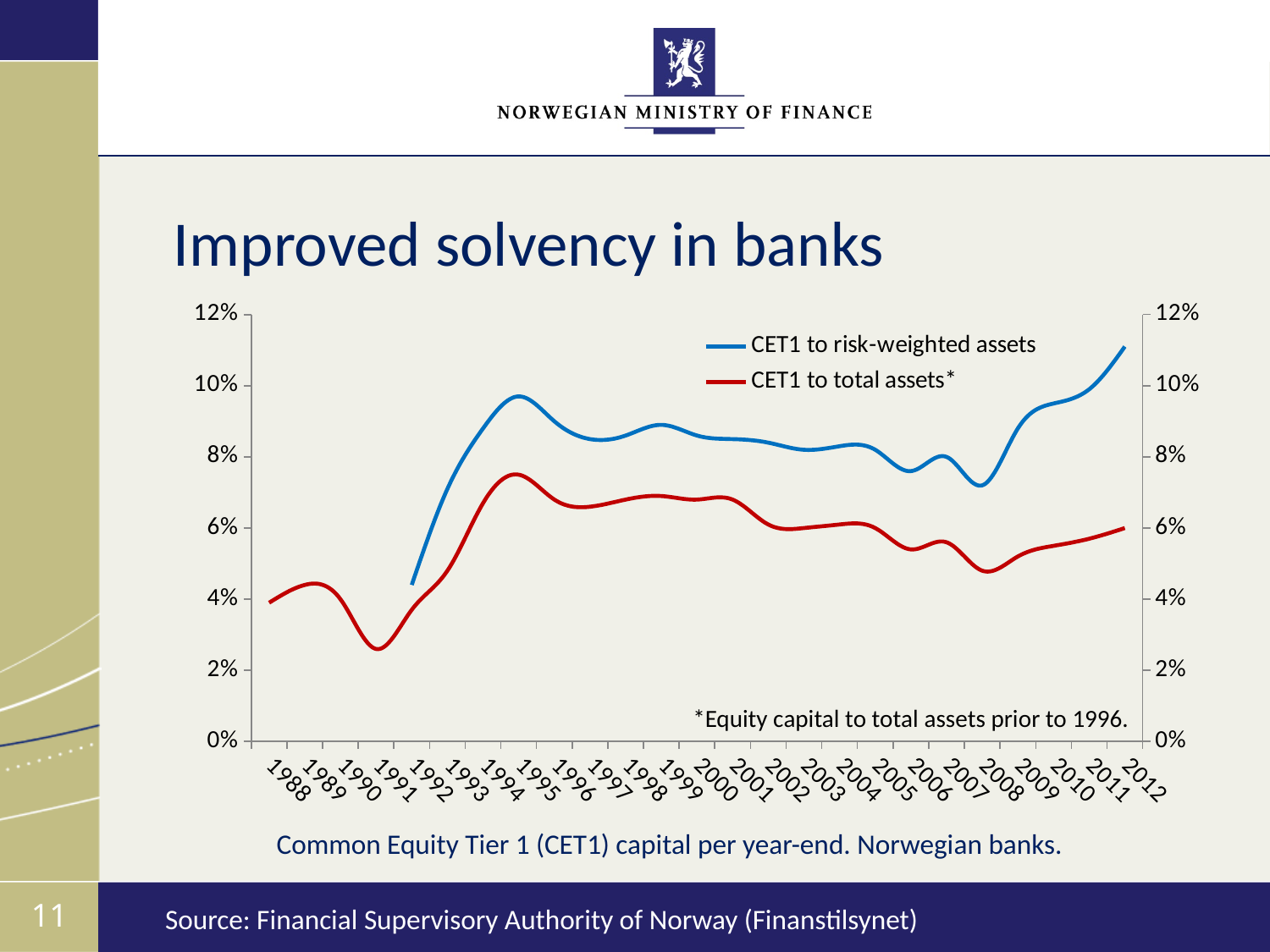
Does CET1 to risk-weighted assets rise or fall from 2008 to 2012? rise In which year is CET1 to risk-weighted assets at its highest? 2012 In 2012, which series has the higher value, CET1 to risk-weighted assets or CET1 to total assets? CET1 to risk-weighted assets In which year is CET1 to total assets at its lowest? 1991 How many years are shown on the x axis? 25 Is the value for CET1 to risk-weighted assets in 1992 greater or less than 6%? less How many series does the legend list? 2 Is the value for CET1 to total assets in 2012 greater or less than 8%? less What kind of chart is shown on the slide? line chart What is the title of the chart slide? Improved solvency in banks Is the value for CET1 to risk-weighted assets in 2012 greater or less than 10%? greater